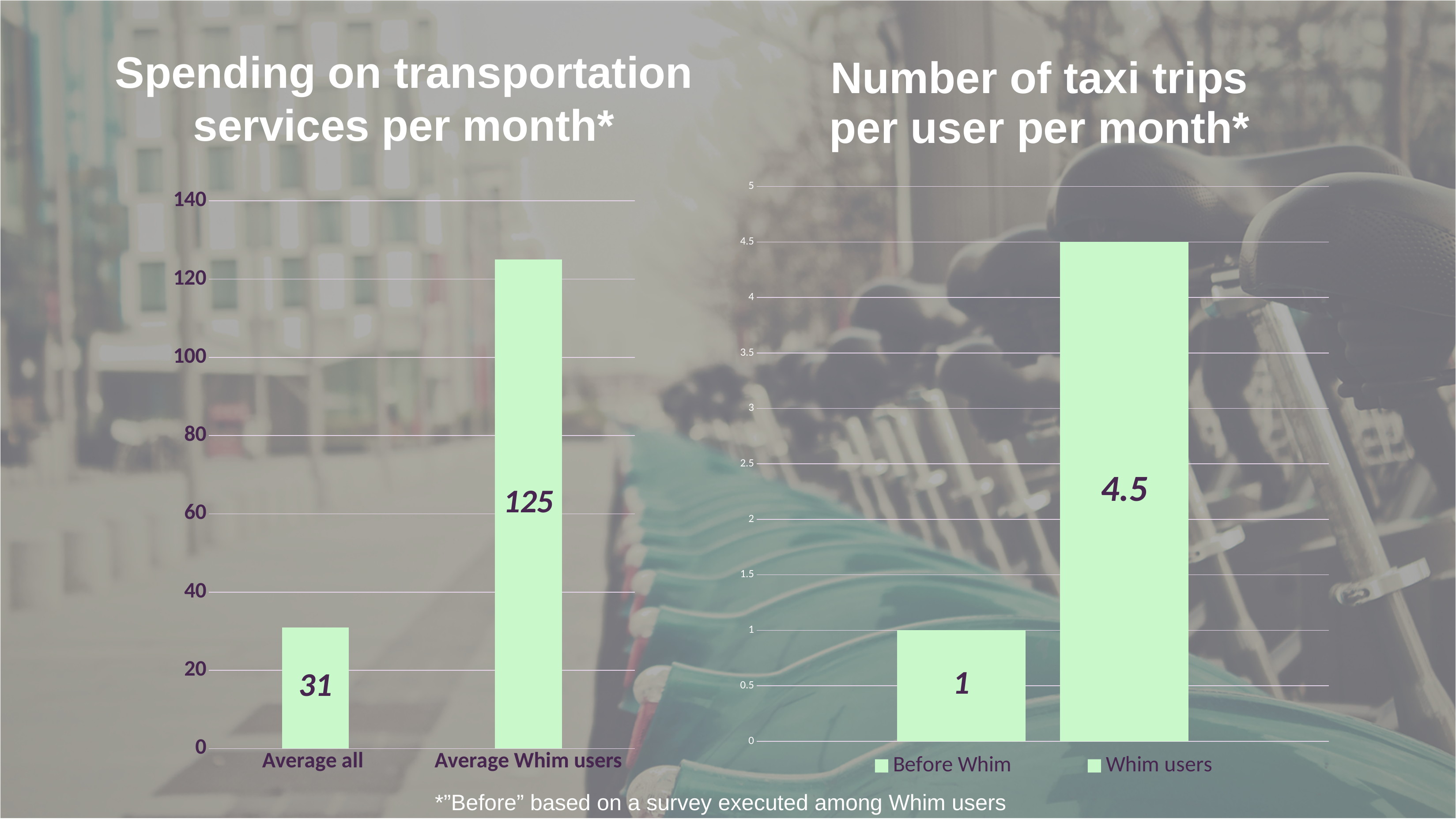
In the 'Spending on transportation services per month*' chart, what is the value for Average all? 31 In the 'Number of taxi trips per user per month*' chart, which has the lower value, Before Whim or Whim users? Before Whim In the 'Number of taxi trips per user per month*' chart, what is the value for Before Whim? 1 In the 'Spending on transportation services per month*' chart, is the value for Average all greater or less than 40? less In the 'Number of taxi trips per user per month*' chart, what is the difference between Whim users and Before Whim? 3.5 In the 'Spending on transportation services per month*' chart, how many bars are plotted? 2 In the 'Spending on transportation services per month*' chart, which category has the highest value? Average Whim users In the 'Spending on transportation services per month*' chart, what is the difference between Average Whim users and Average all? 94 In the 'Spending on transportation services per month*' chart, what is the value for Average Whim users? 125 In the 'Number of taxi trips per user per month*' chart, how many entries does the legend list? 2 What type of chart is the 'Number of taxi trips per user per month*' chart? Bar chart In the 'Number of taxi trips per user per month*' chart, what is the value for Whim users? 4.5